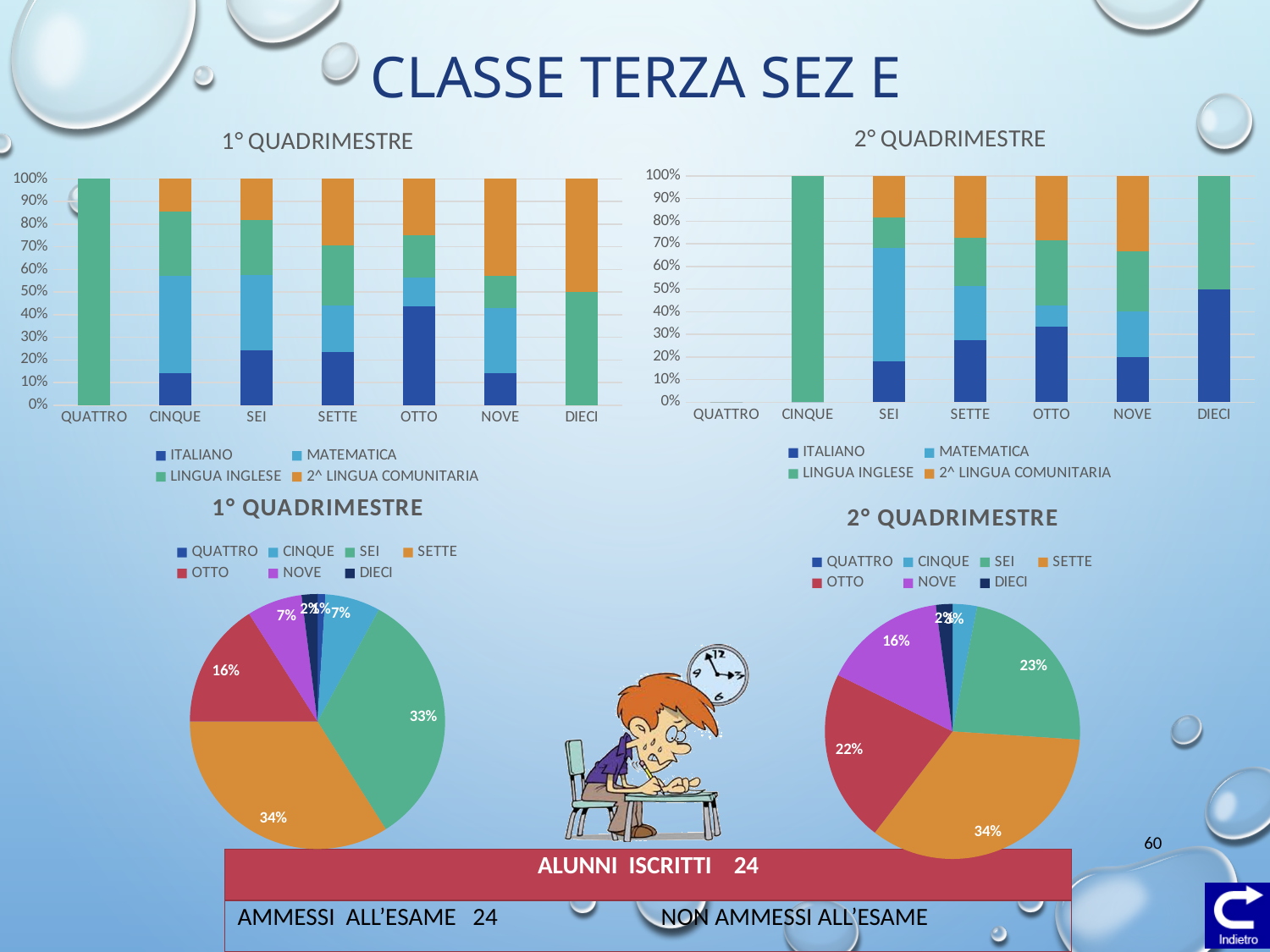
In the bottom-right pie chart (2° QUADRIMESTRE), which category has the largest slice? SETTE What type of chart is the bottom-right chart titled 2° QUADRIMESTRE? pie chart In the top-right bar chart (2° QUADRIMESTRE), how many series does the legend list? 4 In the bottom-left pie chart (1° QUADRIMESTRE), what share does SEI have? 33% In the bottom-left pie chart (1° QUADRIMESTRE), what share does OTTO have? 16% What type of chart is the top-left chart titled 1° QUADRIMESTRE? bar chart In the top-left bar chart (1° QUADRIMESTRE), how many categories are shown on the x axis? 7 In the bottom-right pie chart (2° QUADRIMESTRE), what is the difference between the shares of SEI and OTTO? 1% In the top-right bar chart (2° QUADRIMESTRE), is the ITALIANO value for SEI greater or less than 30%? less In the top-left bar chart (1° QUADRIMESTRE), is the ITALIANO value for OTTO greater or less than 30%? greater In the bottom-right pie chart (2° QUADRIMESTRE), what share does NOVE have? 16%